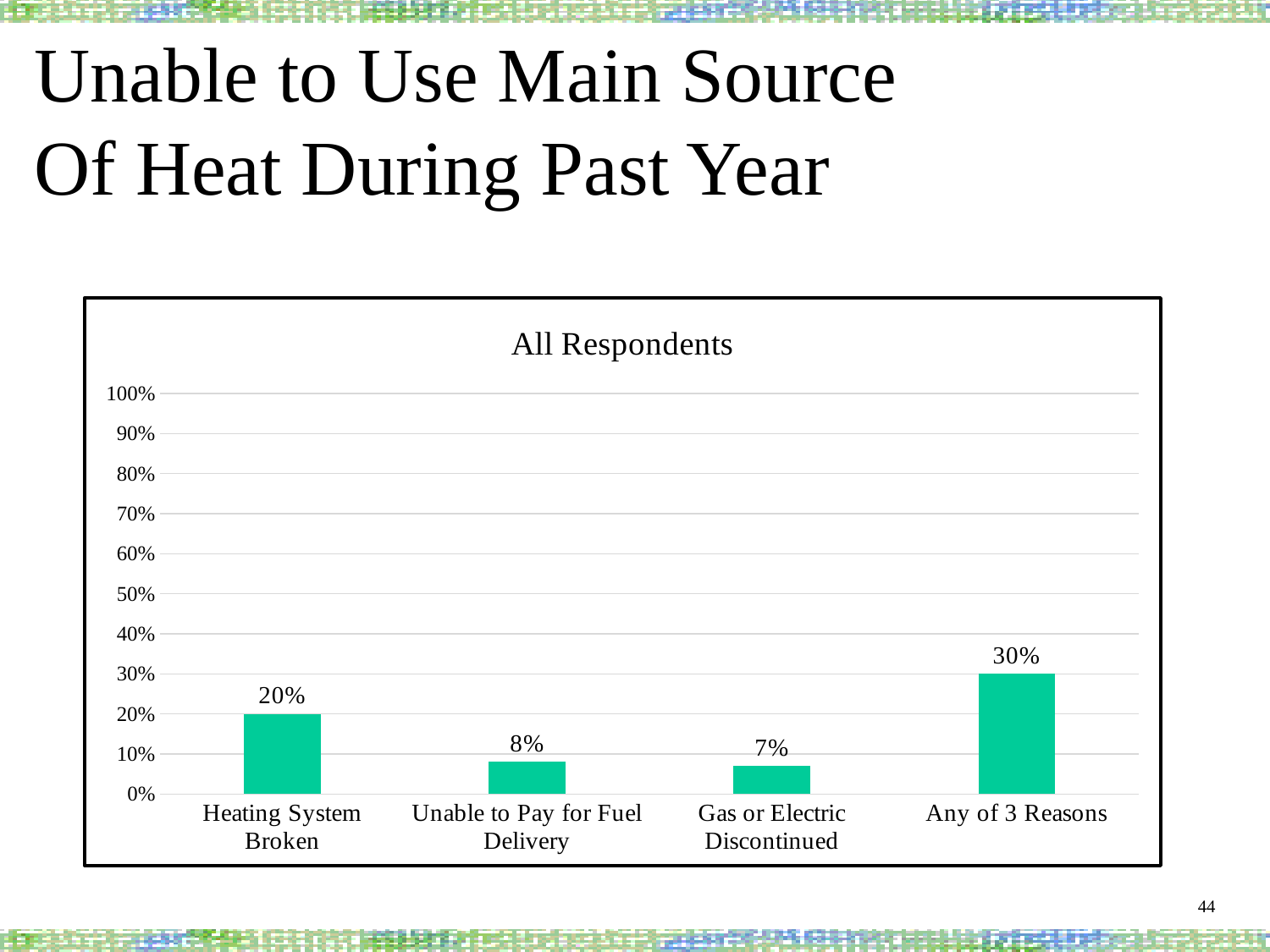
Is the value for Any of 3 Reasons greater or less than 50%? less What is the title of the chart? All Respondents What is the value for Any of 3 Reasons? 30% What kind of chart is shown on the slide? bar chart Which category has the lowest value? Gas or Electric Discontinued How many categories are shown on the chart? 4 What is the value for Gas or Electric Discontinued? 7% Which category has the highest value? Any of 3 Reasons Which is larger, the value for Heating System Broken or the value for Unable to Pay for Fuel Delivery? Heating System Broken What is the value for Heating System Broken? 20% What is the difference between the values for Any of 3 Reasons and Heating System Broken? 10% What is the value for Unable to Pay for Fuel Delivery? 8%